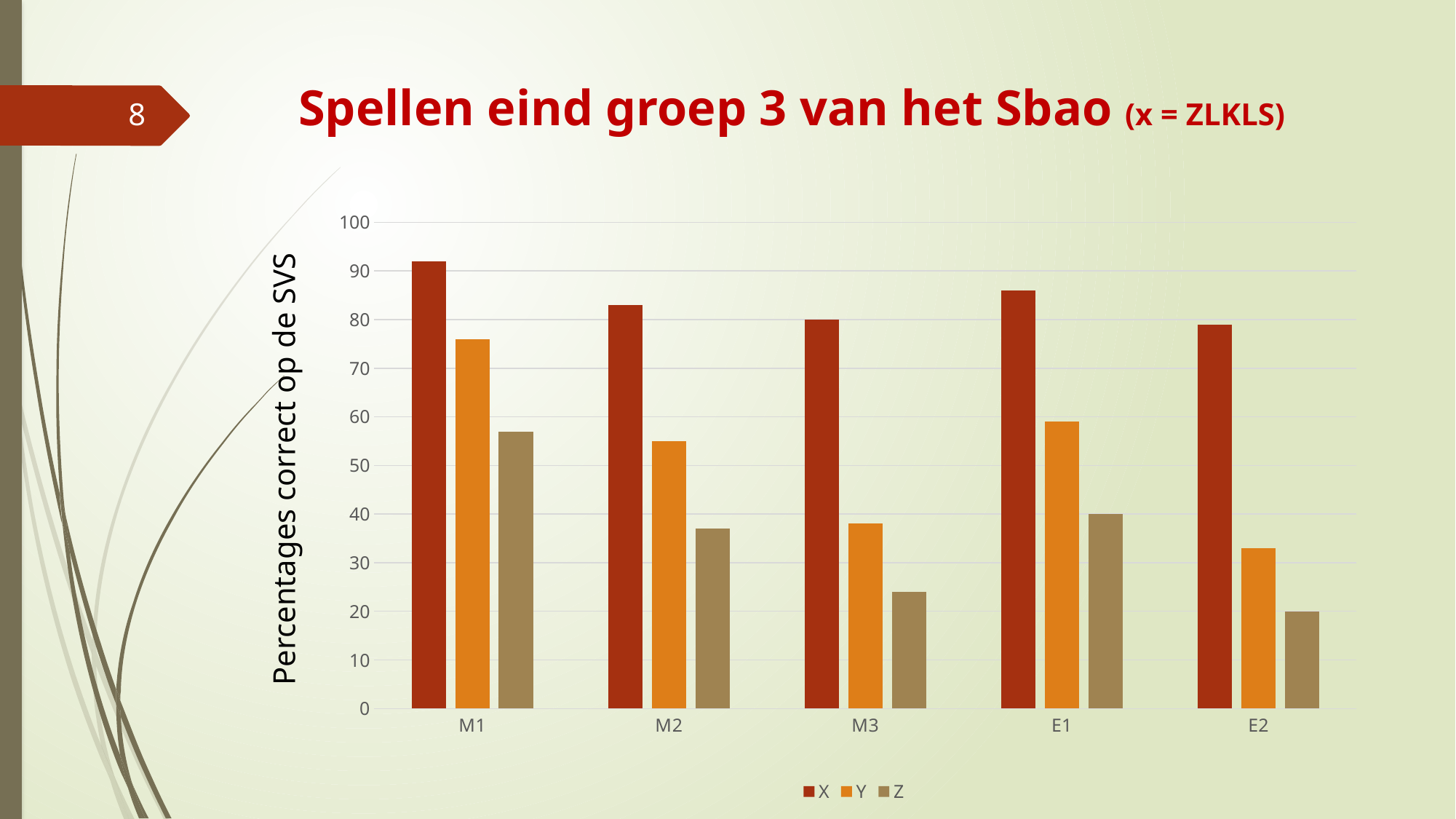
Which is larger: the value for Y at M1 or the value for Y at M2? Y at M1 What is the label of the vertical axis? Percentages correct op de SVS Which category has the lowest value for series Z? E2 What kind of chart is shown on the slide? bar chart Is the value for Z at M3 greater or less than 30? less How many categories are shown on the x axis? 5 Which category has the lowest value for series Y? E2 Which category has the highest value for series X? M1 Is the value for X at M1 greater or less than 80? greater Is the value for X at E1 greater or less than 80? greater How many series does the legend list? 3